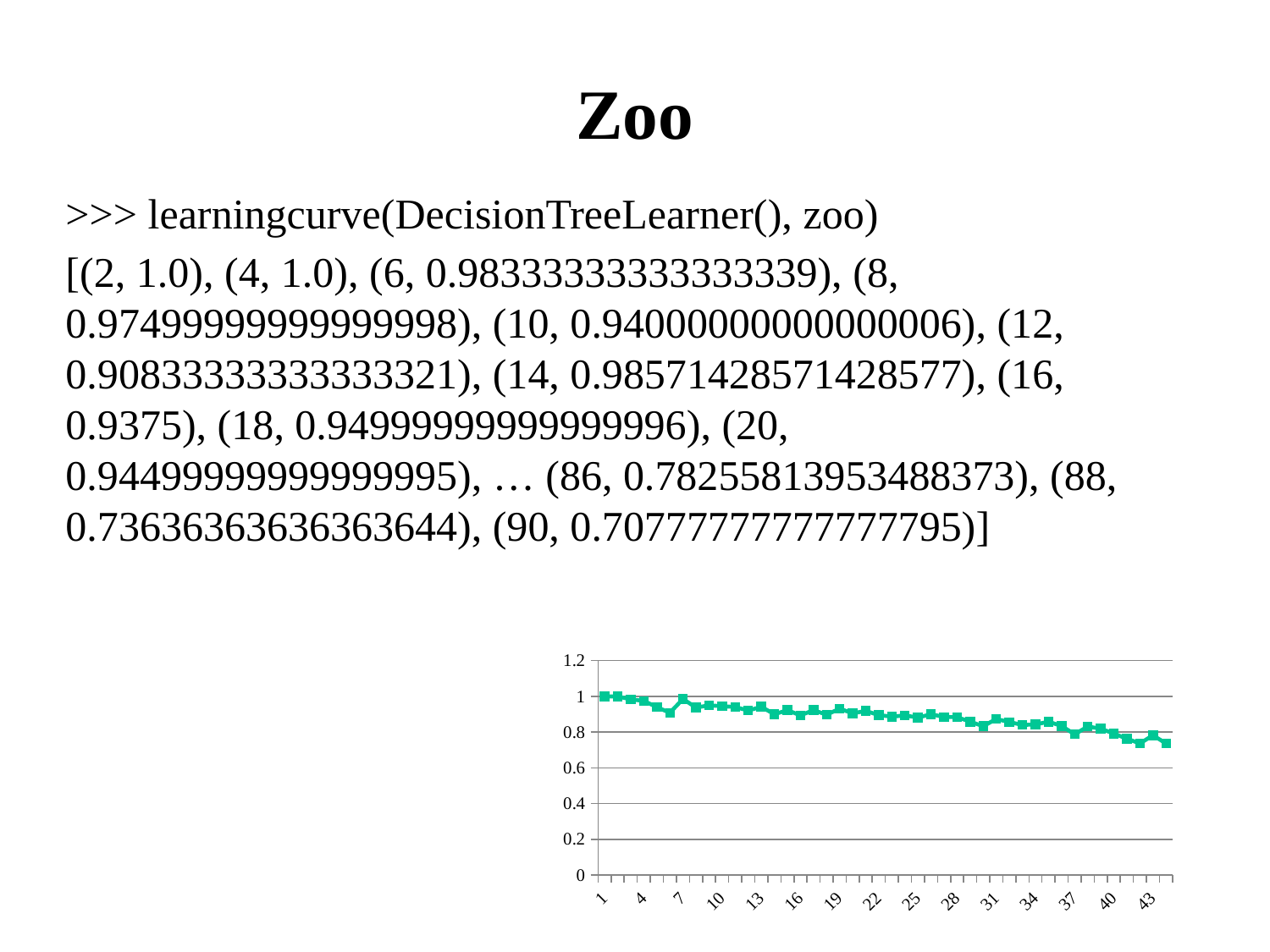
Which is larger, the value plotted at x = 1 or the value plotted at x = 43? x = 1 What is the highest tick value shown on the y axis of the chart? 1.2 What kind of chart is shown at the bottom of the slide? line chart Do the plotted values generally rise or fall as you move from left to right along the x axis? fall Is the value plotted at x = 43 greater or less than 0.6? greater Is the value plotted at x = 22 greater or less than 0.6? greater Is the value plotted at x = 10 greater or less than 1.2? less What is the last label shown on the x axis of the chart? 43 Which is larger, the value plotted at x = 13 or the value plotted at x = 40? x = 13